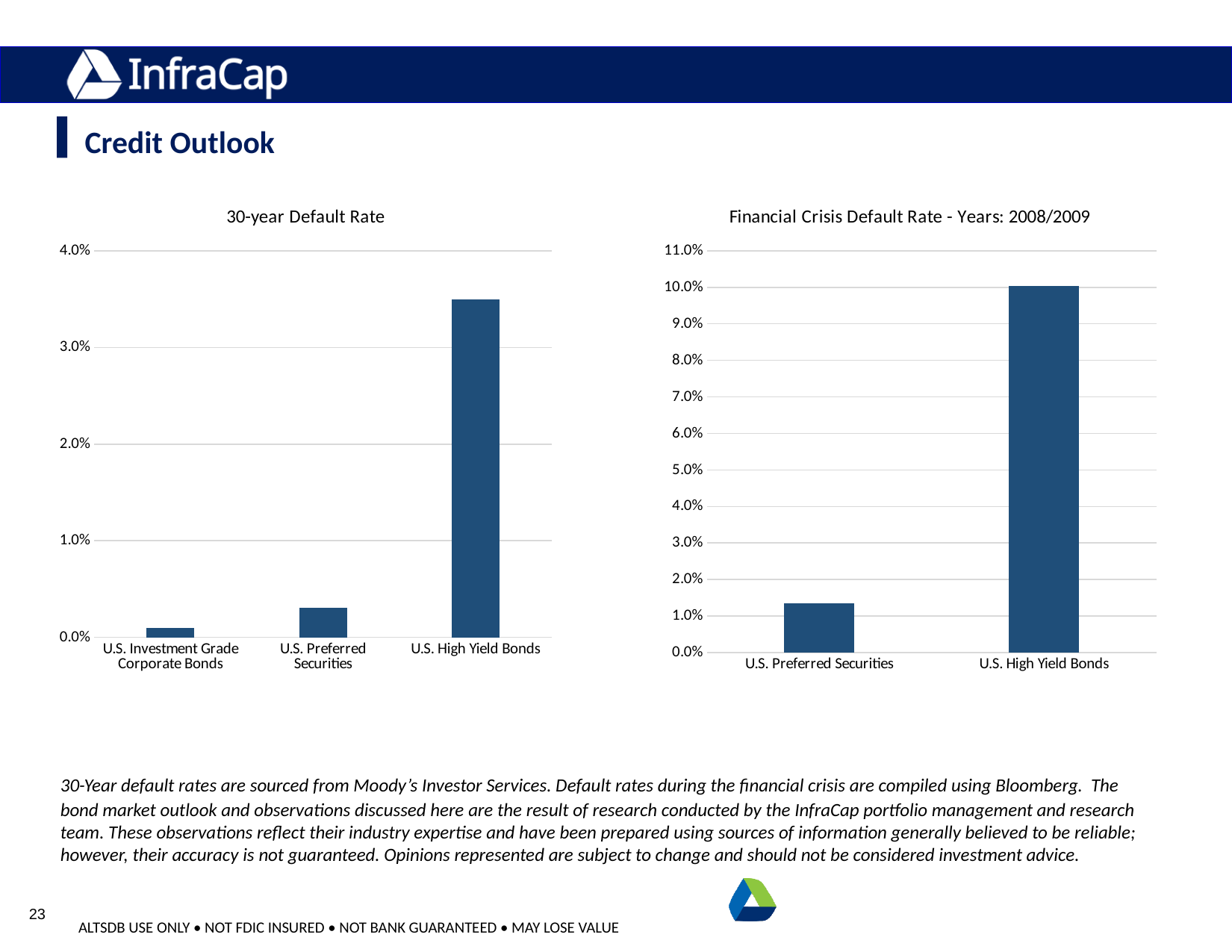
In the 'Financial Crisis Default Rate - Years: 2008/2009' chart, is the value for U.S. High Yield Bonds greater or less than 9.0%? greater In the '30-year Default Rate' chart, which is larger: U.S. Preferred Securities or U.S. Investment Grade Corporate Bonds? U.S. Preferred Securities In the '30-year Default Rate' chart, is the value for U.S. High Yield Bonds greater or less than 3.0%? greater What type of chart is the 'Financial Crisis Default Rate - Years: 2008/2009' chart? Bar chart In the '30-year Default Rate' chart, how many categories are shown? 3 In the '30-year Default Rate' chart, which category has the lowest default rate? U.S. Investment Grade Corporate Bonds In the 'Financial Crisis Default Rate - Years: 2008/2009' chart, is the value for U.S. Preferred Securities greater or less than 2.0%? less In the '30-year Default Rate' chart, which category has the highest default rate? U.S. High Yield Bonds In the 'Financial Crisis Default Rate - Years: 2008/2009' chart, how many categories are shown? 2 In the 'Financial Crisis Default Rate - Years: 2008/2009' chart, which category has the highest default rate? U.S. High Yield Bonds What is the title of the chart on the left side of the slide? 30-year Default Rate